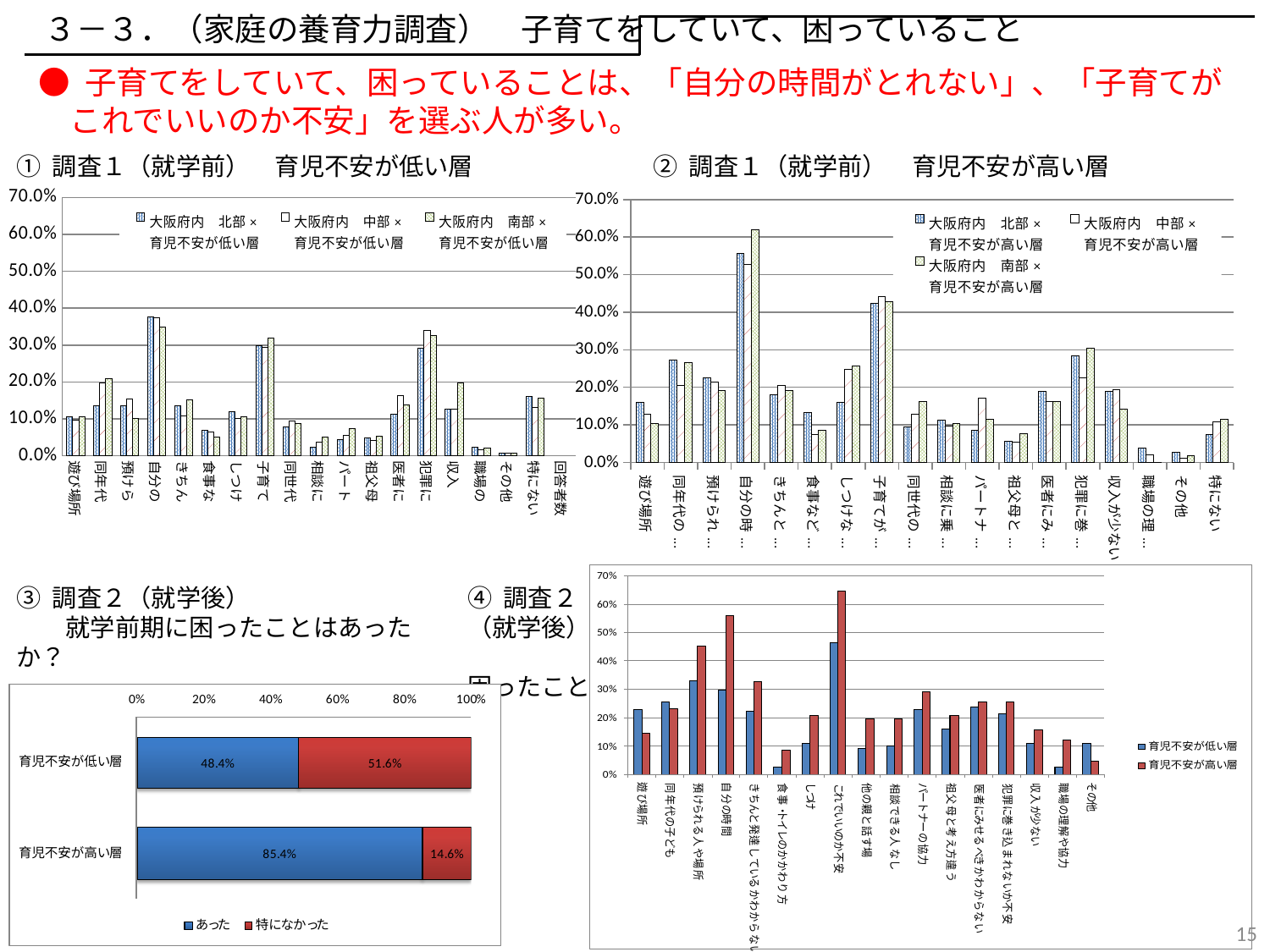
In chart ④ (調査２ 就学後, bottom right), for 遊び場所, which series has the larger value: 育児不安が低い層 or 育児不安が高い層? 育児不安が低い層 In chart ③ (調査２ 就学前期に困ったことはあったか？), what is the value of あった for 育児不安が低い層? 48.4% In chart ② (調査１ 就学前 育児不安が高い層), is the value of 自分の時間 for 大阪府内 南部 greater or less than 50%? greater In chart ④ (調査２ 就学後, bottom right), which category has the highest value for 育児不安が高い層? これでいいのか不安 In chart ① (調査１ 就学前 育児不安が低い層), how many series does the legend list? 3 In chart ③ (調査２ 就学前期に困ったことはあったか？), what is the difference between the あった values for 育児不安が高い層 and 育児不安が低い層? 37.0% In chart ③ (調査２ 就学前期に困ったことはあったか？), what is the value of あった for 育児不安が高い層? 85.4% In chart ④ (調査２ 就学後, bottom right), is the value of 自分の時間 for 育児不安が高い層 greater or less than 50%? greater In chart ③ (調査２ 就学前期に困ったことはあったか？), what is the value of 特になかった for 育児不安が高い層? 14.6% In chart ③ (調査２ 就学前期に困ったことはあったか？), what is the total of the stacked bar for 育児不安が低い層? 100% In chart ③ (調査２ 就学前期に困ったことはあったか？), how many series does the legend list? 2 In chart ③ (調査２ 就学前期に困ったことはあったか？), what kind of chart is it? Stacked bar chart